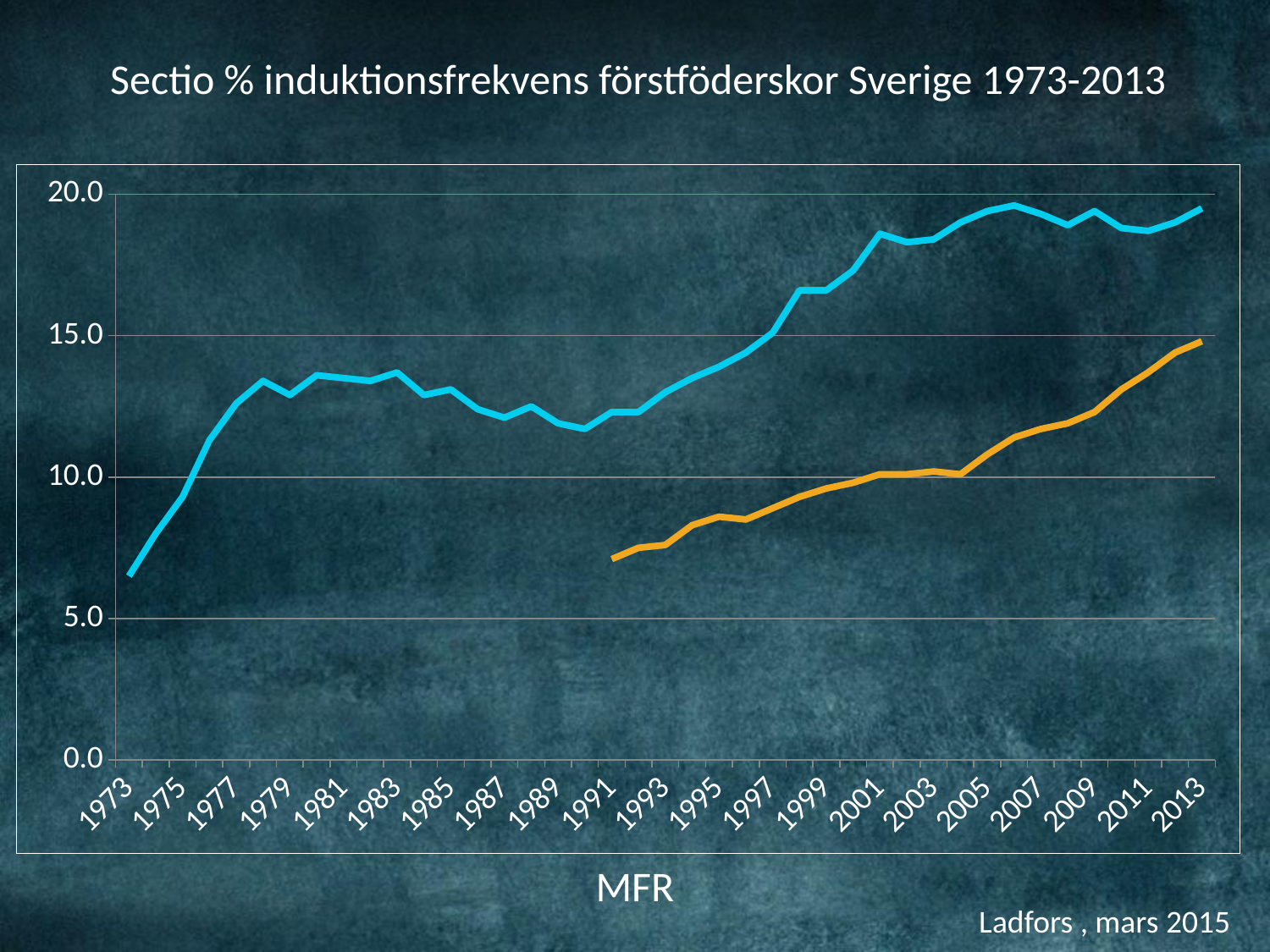
Is the value of the blue line in 2013 greater or less than 15.0? greater How many lines are plotted on the chart? 2 Is the value of the orange line in 1991 greater or less than 10.0? less In 2013, which line has the higher value, the blue line or the orange line? the blue line Does the blue line rise or fall from 1973 to 1979? rise What label is shown below the x axis of the chart? MFR Does the orange line rise or fall overall from 1991 to 2013? rise Is the value of the blue line in 2001 greater or less than 15.0? greater What kind of chart is shown on the slide? line chart What is the title of the chart? Sectio % induktionsfrekvens förstföderskor Sverige 1973-2013